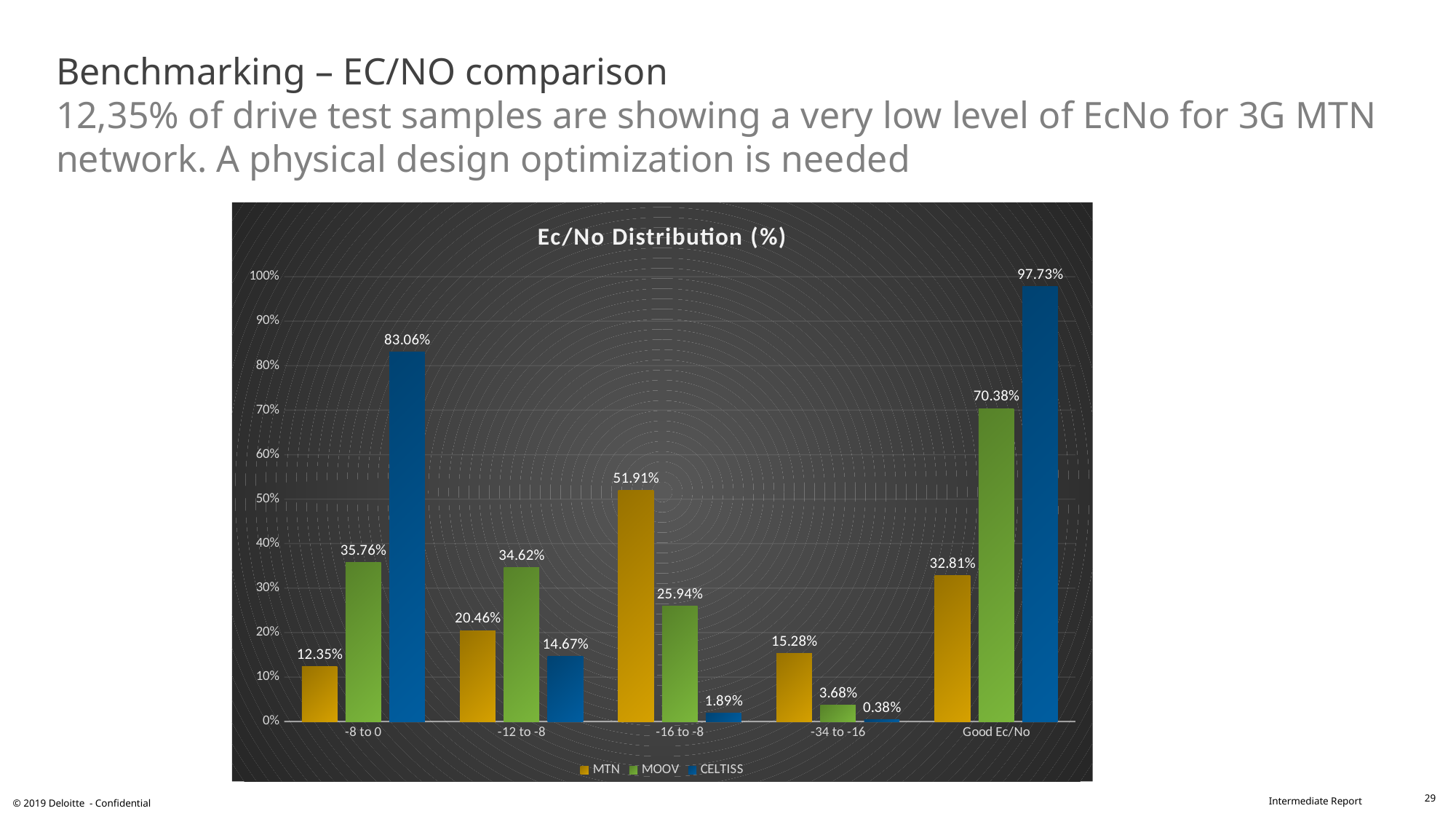
How many categories are shown on the x axis? 5 Which series has the highest value in the "Good Ec/No" category? CELTISS What is the value for CELTISS in the "-8 to 0" category? 83.06% Which series has the lowest value in the "-8 to 0" category? MTN How many series does the legend list? 3 What is the value for MOOV in the "Good Ec/No" category? 70.38% What is the title of the chart? Ec/No Distribution (%) What is the difference between the CELTISS and MTN values in the "Good Ec/No" category? 64.92% What is the value for CELTISS in the "-34 to -16" category? 0.38% Which is larger in the "-12 to -8" category: MTN or MOOV? MOOV What kind of chart is shown on the slide? Bar chart What is the value for MTN in the "-16 to -8" category? 51.91%